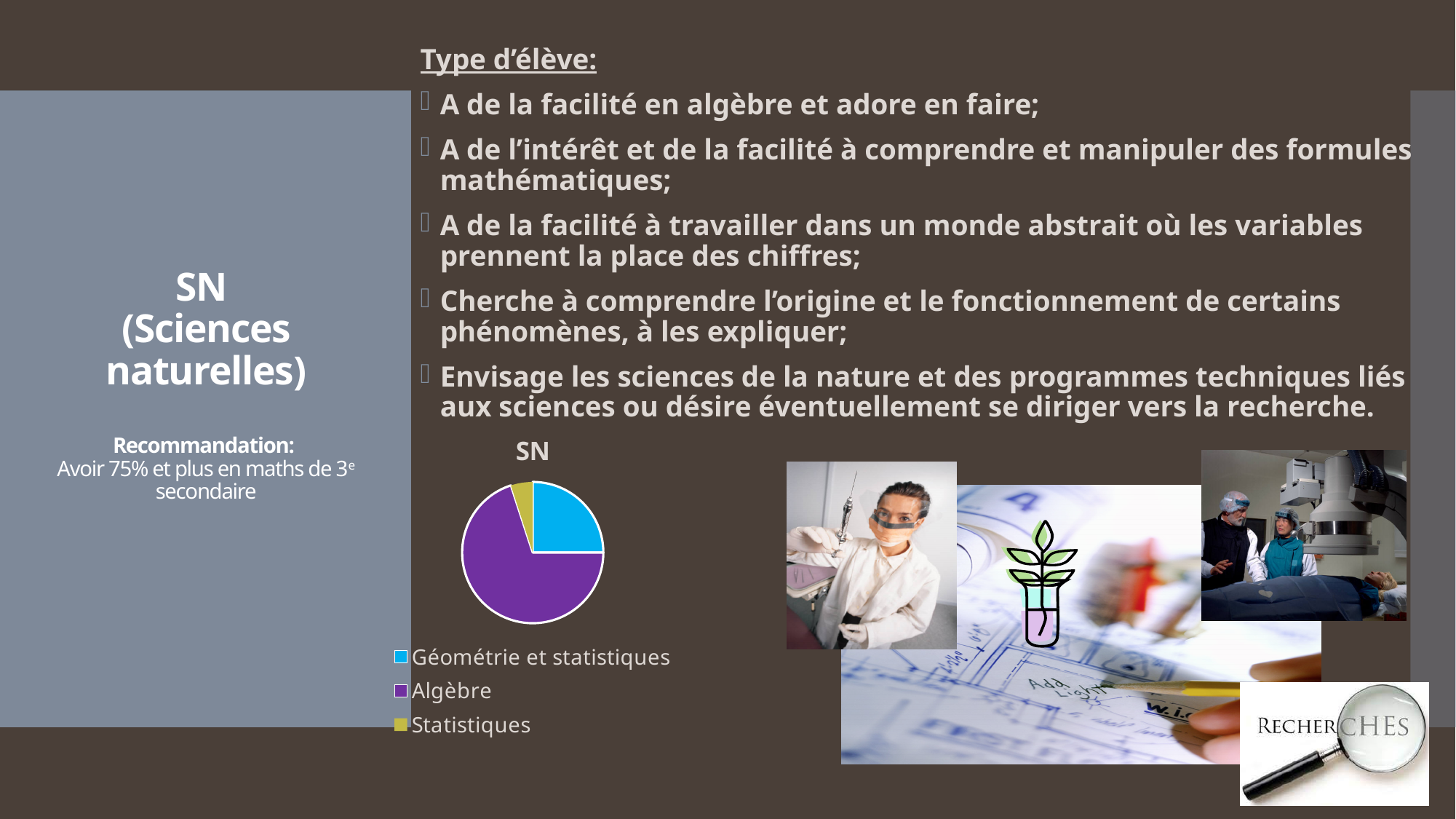
Which slice is larger, Géométrie et statistiques or Statistiques? Géométrie et statistiques What is the title of the pie chart? SN Which category has the smallest slice in the pie chart? Statistiques Which category has the largest slice in the pie chart? Algèbre What kind of chart is shown on the slide? pie chart Which slice is larger, Algèbre or Géométrie et statistiques? Algèbre How many entries does the legend of the pie chart list? 3 How many slices does the pie chart have? 3 Which colour represents Algèbre in the pie chart? purple